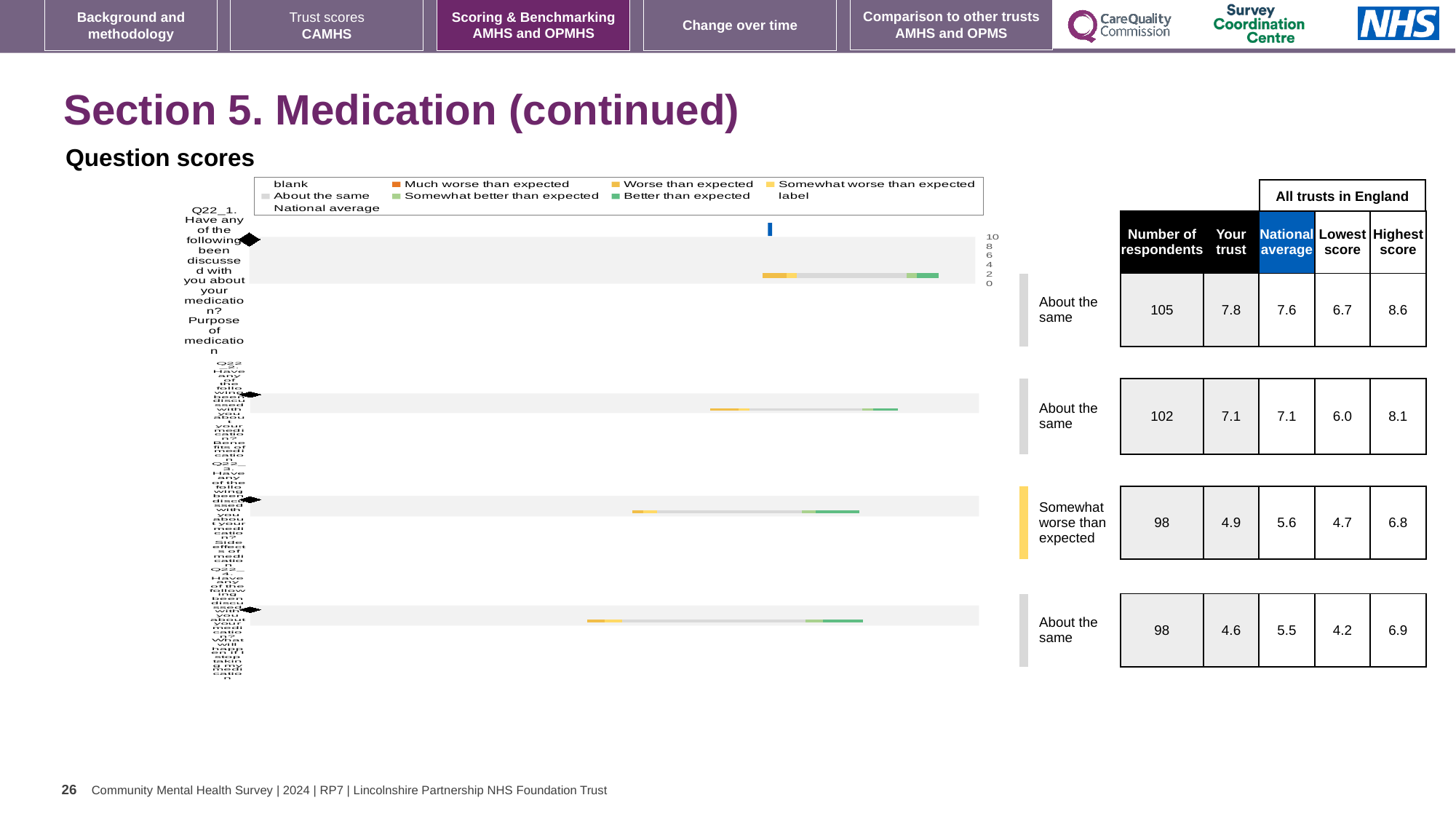
Which legend entry is shown in light grey? About the same In the table beside the chart, what is the highest score for the fourth question row? 6.9 Which legend entry is shown in dark green? Better than expected What kind of chart is shown under 'Question scores'? bar chart In the table beside the chart, which benchmark category is given for the third question row? Somewhat worse than expected In the table beside the chart, what is the 'Your trust' score for the first question row (Q22_1, purpose of medication)? 7.8 In the table beside the chart, how many respondents are listed for the second question row? 102 How many entries does the chart legend list? 9 How many question bars are plotted in the chart? 4 In the table beside the chart, which question row has the lowest 'Your trust' score? the fourth row (4.6) In the table beside the chart, what is the difference between the 'Your trust' score and the national average for the third question row? 0.7 In the table beside the chart, what is the national average for the first question row (Q22_1)? 7.6